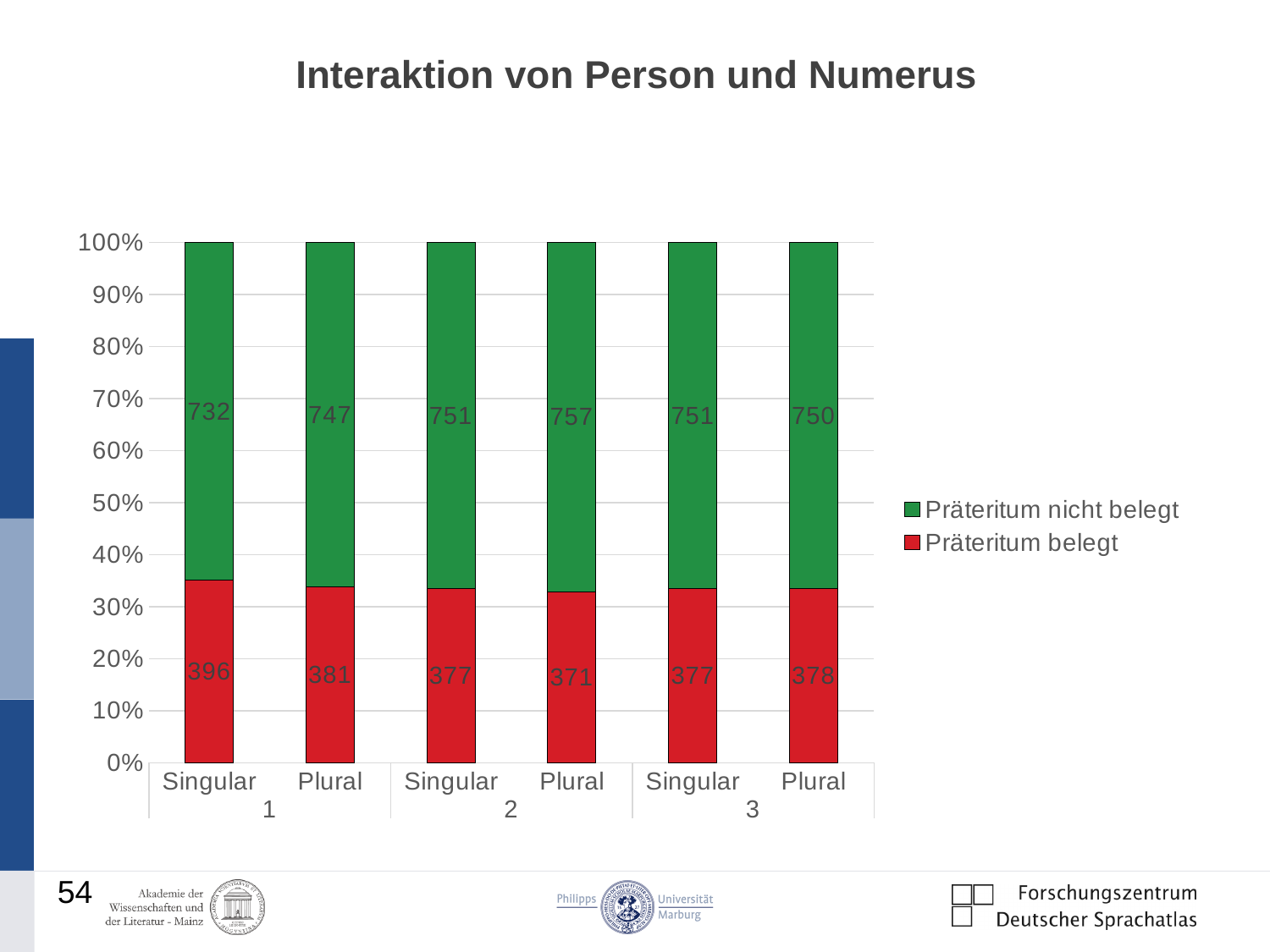
What kind of chart is shown on the slide? Stacked bar chart What is the difference between the "Präteritum belegt" values for Singular and Plural in group 1? 15 Which is larger: "Präteritum nicht belegt" for Plural in group 1 or for Plural in group 2? Plural in group 2 Which category has the lowest value for "Präteritum nicht belegt"? Singular in group 1 What is the total of the stacked bar for Singular in group 2? 1128 Which category has the highest value for "Präteritum belegt"? Singular in group 1 What is the value of "Präteritum belegt" for Plural in group 3? 378 What is the value of "Präteritum belegt" for Singular in group 1? 396 What is the value of "Präteritum nicht belegt" for Plural in group 2? 757 How many bars are shown in the chart? 6 What is the title of the chart? Interaktion von Person und Numerus How many series does the legend list? 2